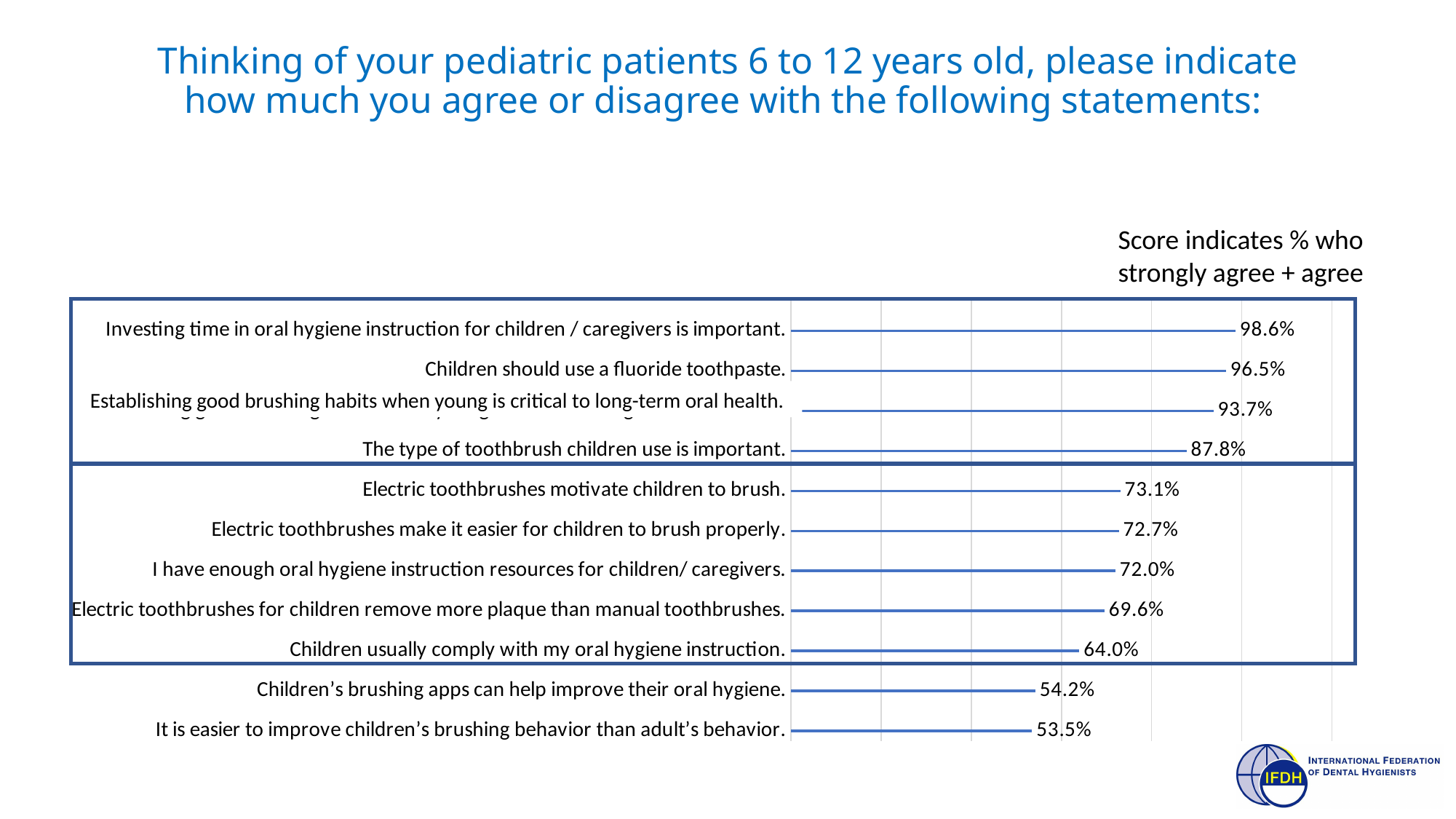
What is the value for the statement 'Children should use a fluoride toothpaste'? 96.5% Which statement has the lowest percentage of agreement? It is easier to improve children's brushing behavior than adult's behavior. How many statements are plotted in the chart? 11 What is the value for the statement 'Children usually comply with my oral hygiene instruction'? 64.0% What type of chart is shown on the slide? Bar chart According to the note on the slide, what does the score indicate? % who strongly agree + agree Which has a higher value: 'Children's brushing apps can help improve their oral hygiene' or 'Electric toothbrushes for children remove more plaque than manual toothbrushes'? Electric toothbrushes for children remove more plaque than manual toothbrushes. What is the difference between the values for 'Children should use a fluoride toothpaste' and 'Establishing good brushing habits when young is critical to long-term oral health'? 2.8% What is the value for the statement 'Electric toothbrushes motivate children to brush'? 73.1% What percentage of respondents strongly agree or agree that investing time in oral hygiene instruction for children / caregivers is important? 98.6% What is the difference between the values for 'The type of toothbrush children use is important' and 'Electric toothbrushes motivate children to brush'? 14.7% Which statement has the highest percentage of agreement? Investing time in oral hygiene instruction for children / caregivers is important.